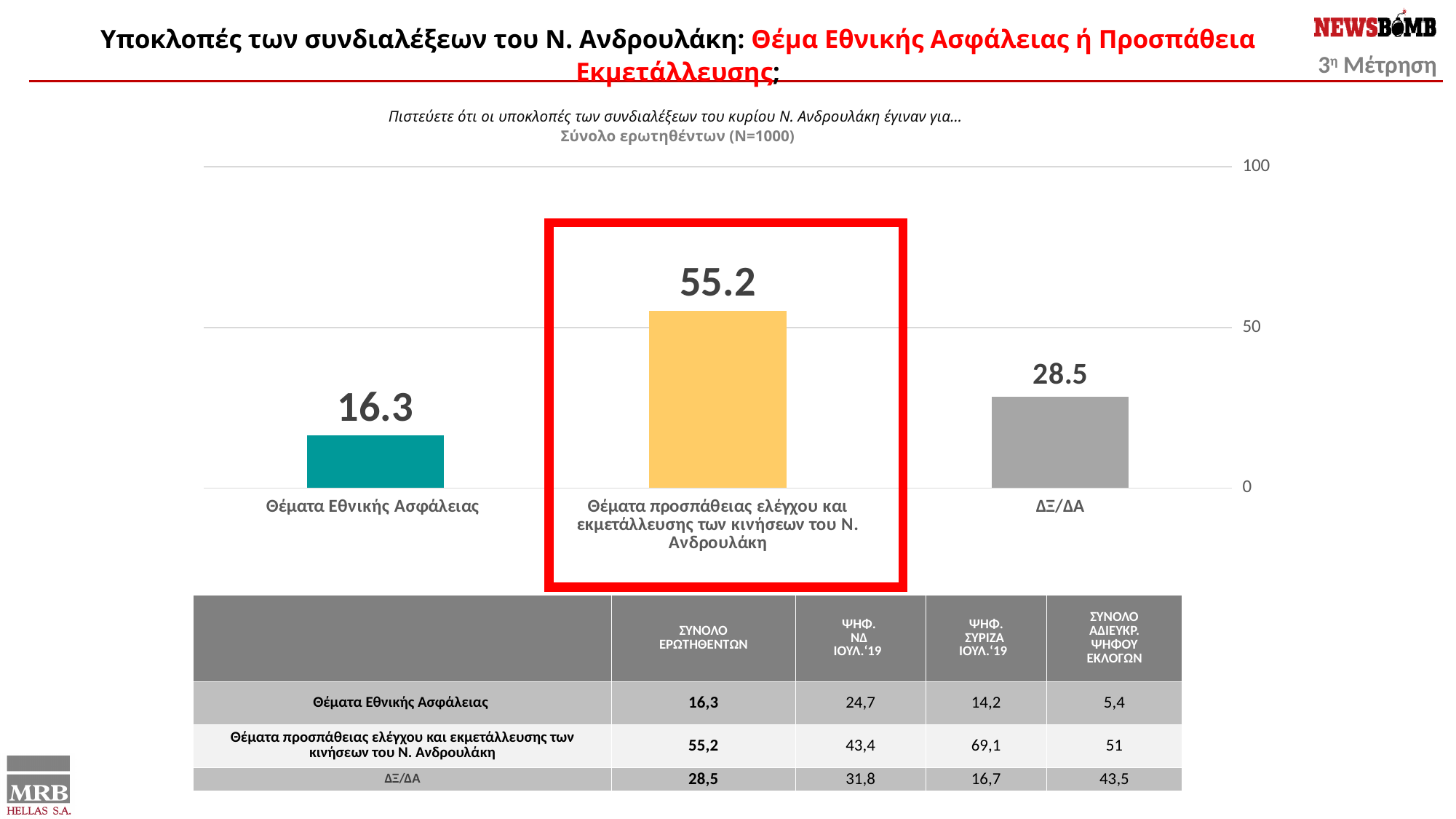
What is the value for ΔΞ/ΔΑ? 28.5 What is the difference between the value for ΔΞ/ΔΑ and the value for Θέματα Εθνικής Ασφάλειας? 12.2 Which category has the highest value? Θέματα προσπάθειας ελέγχου και εκμετάλλευσης των κινήσεων του Ν. Ανδρουλάκη What colour is the bar for Θέματα Εθνικής Ασφάλειας? teal What is the value for Θέματα προσπάθειας ελέγχου και εκμετάλλευσης των κινήσεων του Ν. Ανδρουλάκη? 55.2 Is the value for Θέματα προσπάθειας ελέγχου και εκμετάλλευσης των κινήσεων του Ν. Ανδρουλάκη greater or less than 50? greater Which category has the lowest value? Θέματα Εθνικής Ασφάλειας What kind of chart is shown on the slide? bar chart How many categories are shown in the bar chart? 3 What is the value for Θέματα Εθνικής Ασφάλειας? 16.3 What is the difference between the value for Θέματα προσπάθειας ελέγχου και εκμετάλλευσης των κινήσεων του Ν. Ανδρουλάκη and the value for ΔΞ/ΔΑ? 26.7 Which is larger, the value for ΔΞ/ΔΑ or the value for Θέματα Εθνικής Ασφάλειας? ΔΞ/ΔΑ